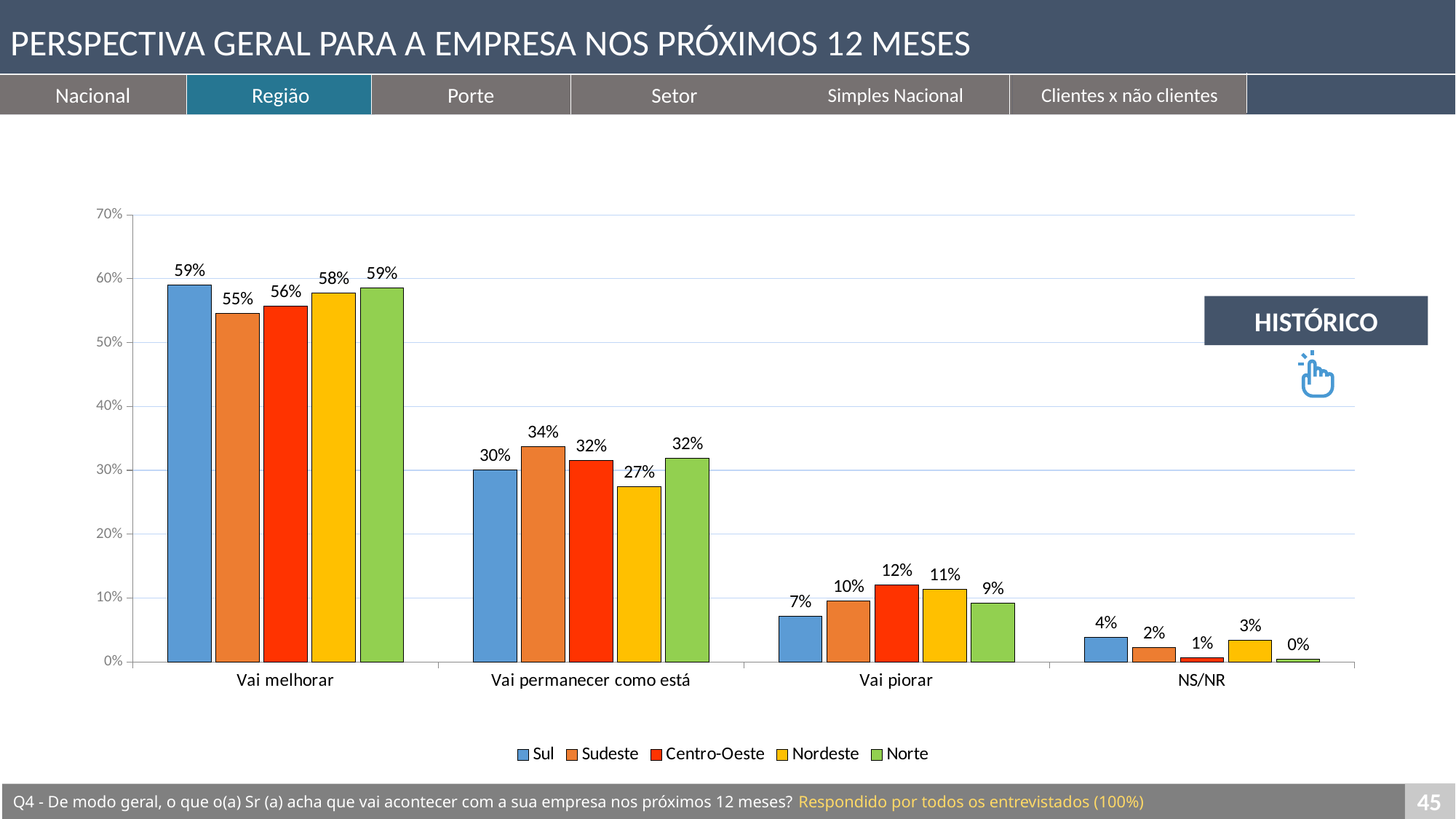
How many series does the legend list? 5 What is the difference between the Sul and Sudeste values in the "Vai melhorar" category? 4% What is the value for Nordeste in the "Vai permanecer como está" category? 27% Is the value for Nordeste in the "Vai melhorar" category greater or less than 50%? greater What is the value for Sudeste in the "Vai melhorar" category? 55% Which region has the lowest value in the "Vai piorar" category? Sul Which region has the highest value in the "Vai permanecer como está" category? Sudeste What is the value for Centro-Oeste in the "Vai piorar" category? 12% How many categories are shown on the x axis? 4 What is the value for Norte in the "NS/NR" category? 0% What kind of chart is shown on the slide? Bar chart In the "Vai piorar" category, which is larger: the value for Sudeste or the value for Norte? Sudeste